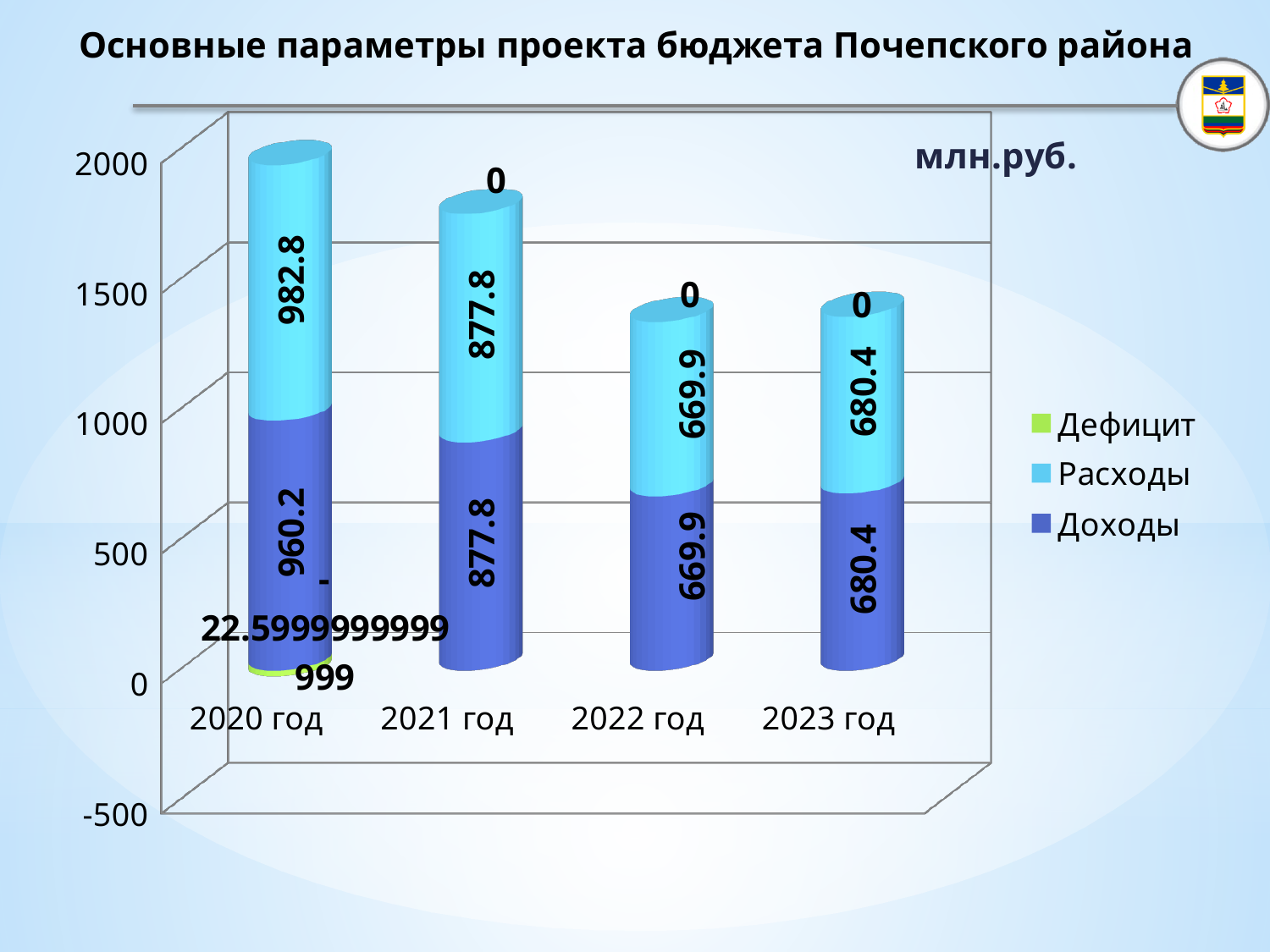
Which year has the highest value of Доходы? 2020 год What kind of chart is shown on the slide? Stacked bar chart What is the value of Доходы for 2020 год? 960.2 What is the value of Расходы for 2023 год? 680.4 What is the value of Дефицит for 2021 год? 0 Which year has the lowest value of Расходы? 2022 год What is the difference between Расходы and Доходы for 2020 год? 22.6 Which is larger, Доходы for 2021 год or Доходы for 2023 год? 2021 год How many years are shown on the x axis? 4 What is the value of Доходы for 2022 год? 669.9 How many series does the legend list? 3 What is the value of Расходы for 2020 год? 982.8